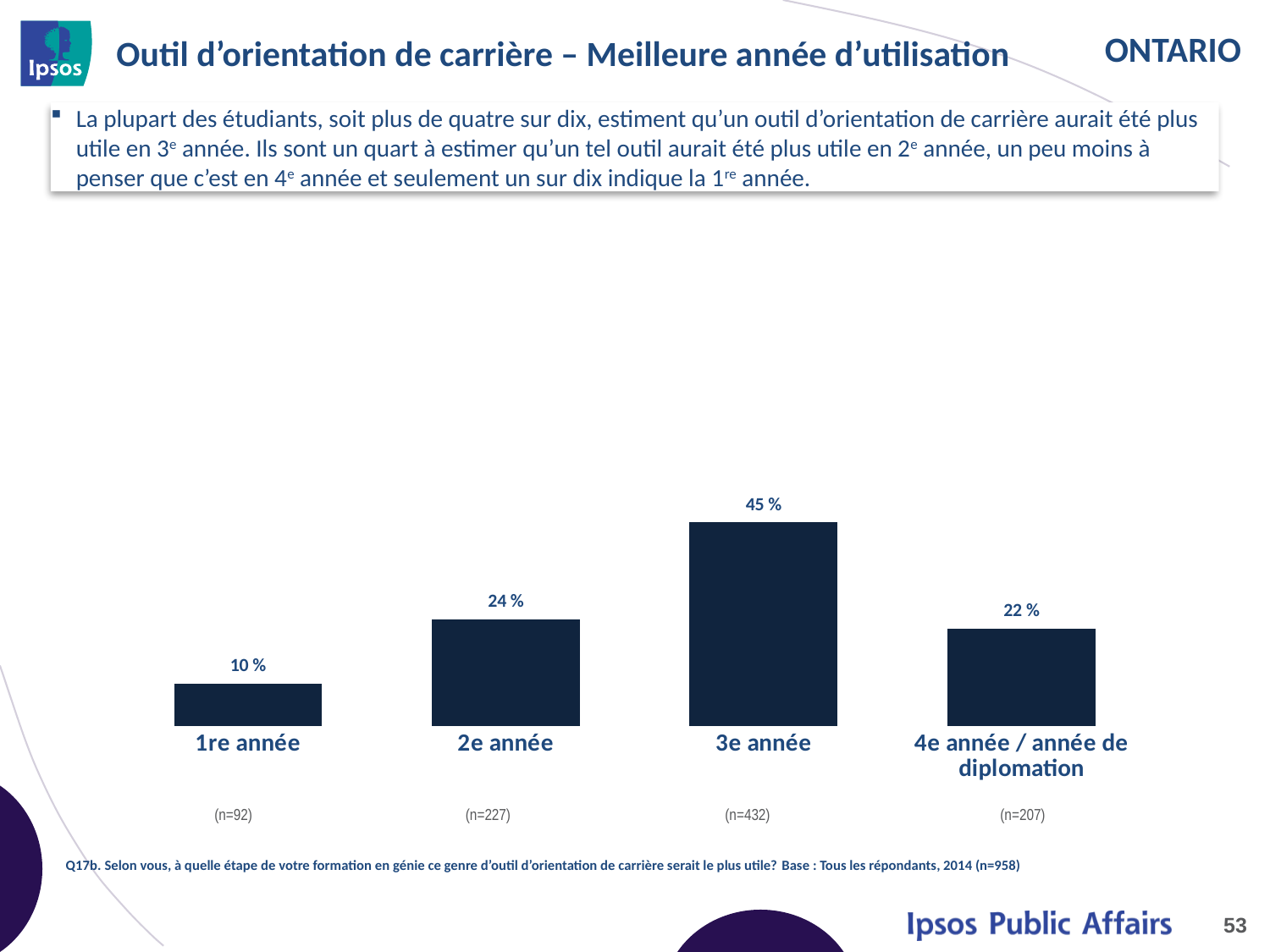
Which category has the lowest value? 1re année What is the difference between the values for 2e année and 1re année? 14 % What is the value for 1re année? 10 % What is the value for 4e année / année de diplomation? 22 % How many categories are shown in the chart? 4 Which category has the highest value? 3e année Which is larger, the value for 2e année or the value for 4e année / année de diplomation? 2e année What is the value for 3e année? 45 % What kind of chart is shown on the slide? Bar chart What is the difference between the values for 3e année and 2e année? 21 % What is the value for 2e année? 24 % What is the sample size (n) shown under the 3e année bar? (n=432)